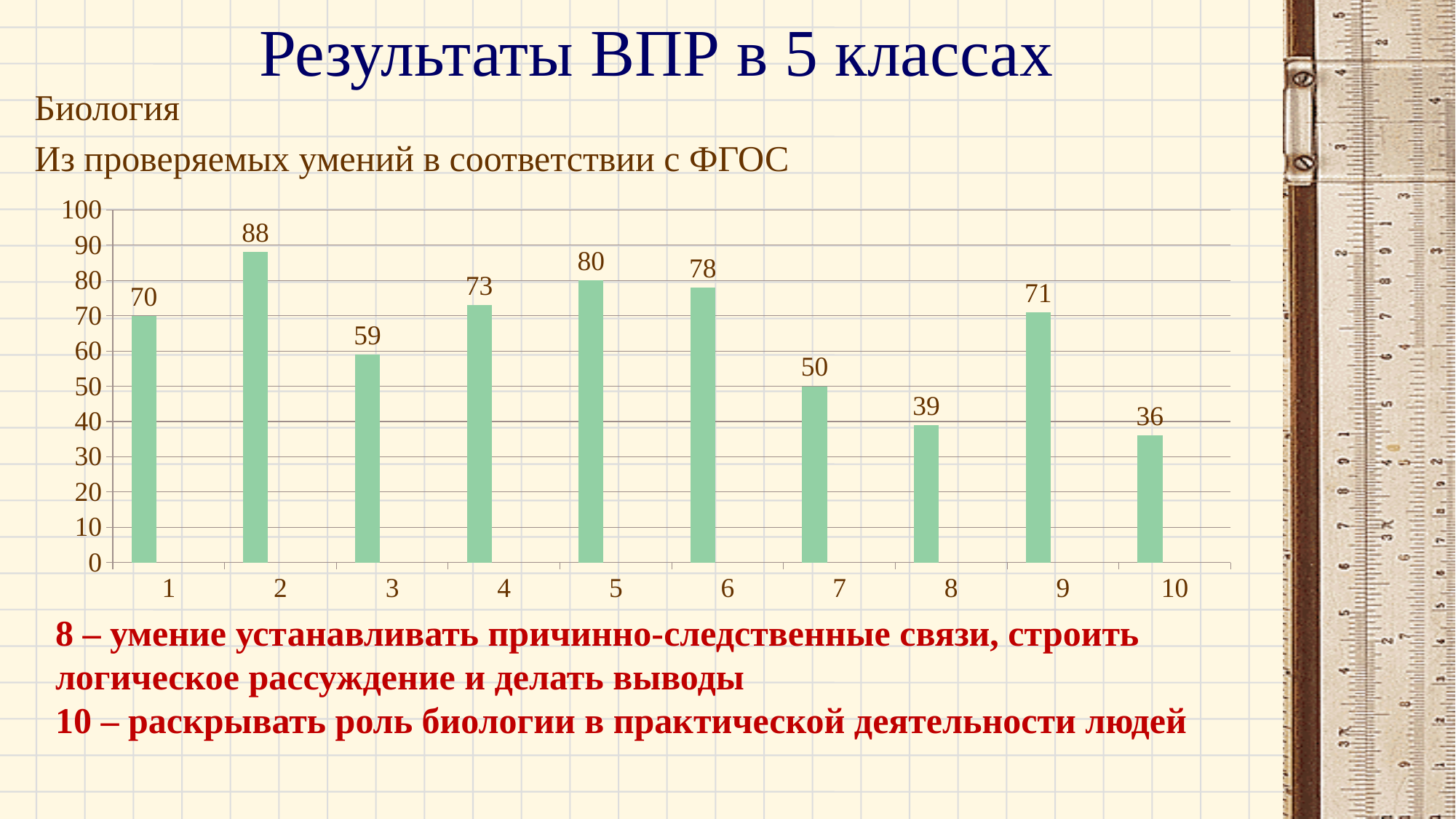
What kind of chart is shown on the slide? bar chart What is the difference between the values for category 5 and category 6? 2 What is the value for category 2? 88 What is the value for category 7? 50 Which category has the lowest value? 10 What is the difference between the values for category 2 and category 10? 52 Which category has the highest value? 2 What is the highest tick value shown on the y axis? 100 Is the value for category 8 greater or less than 40? less How many categories are shown on the x axis? 10 What is the value for category 10? 36 Which is larger, the value for category 3 or the value for category 4? 4